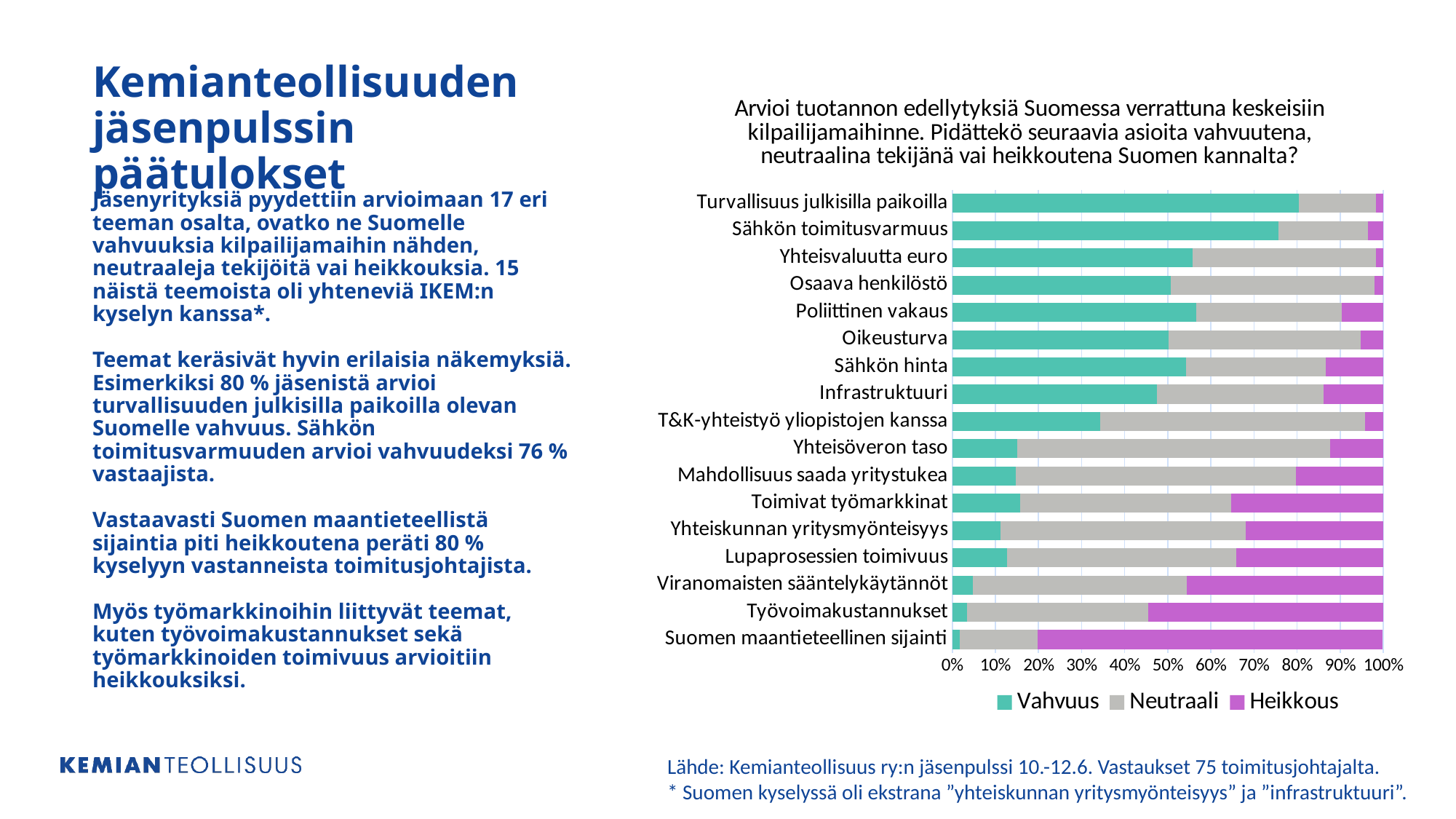
Is the Vahvuus share for Turvallisuus julkisilla paikoilla greater or less than 70%? greater What kind of chart is shown on the slide? Stacked bar chart Which category has the smallest Vahvuus share? Suomen maantieteellinen sijainti Which has the larger Heikkous share: Viranomaisten sääntelykäytännöt or Lupaprosessien toimivuus? Viranomaisten sääntelykäytännöt Which has the larger Vahvuus share: Sähkön toimitusvarmuus or Yhteisvaluutta euro? Sähkön toimitusvarmuus Which category has the largest Heikkous share? Suomen maantieteellinen sijainti Is the Vahvuus share for Työvoimakustannukset greater or less than 10%? less Which category has the largest Vahvuus share? Turvallisuus julkisilla paikoilla What are the three series named in the legend? Vahvuus, Neutraali, Heikkous How many series does the chart legend list? 3 How many categories (themes) are listed on the chart's vertical axis? 17 Is the Heikkous share for Suomen maantieteellinen sijainti greater or less than 70%? greater